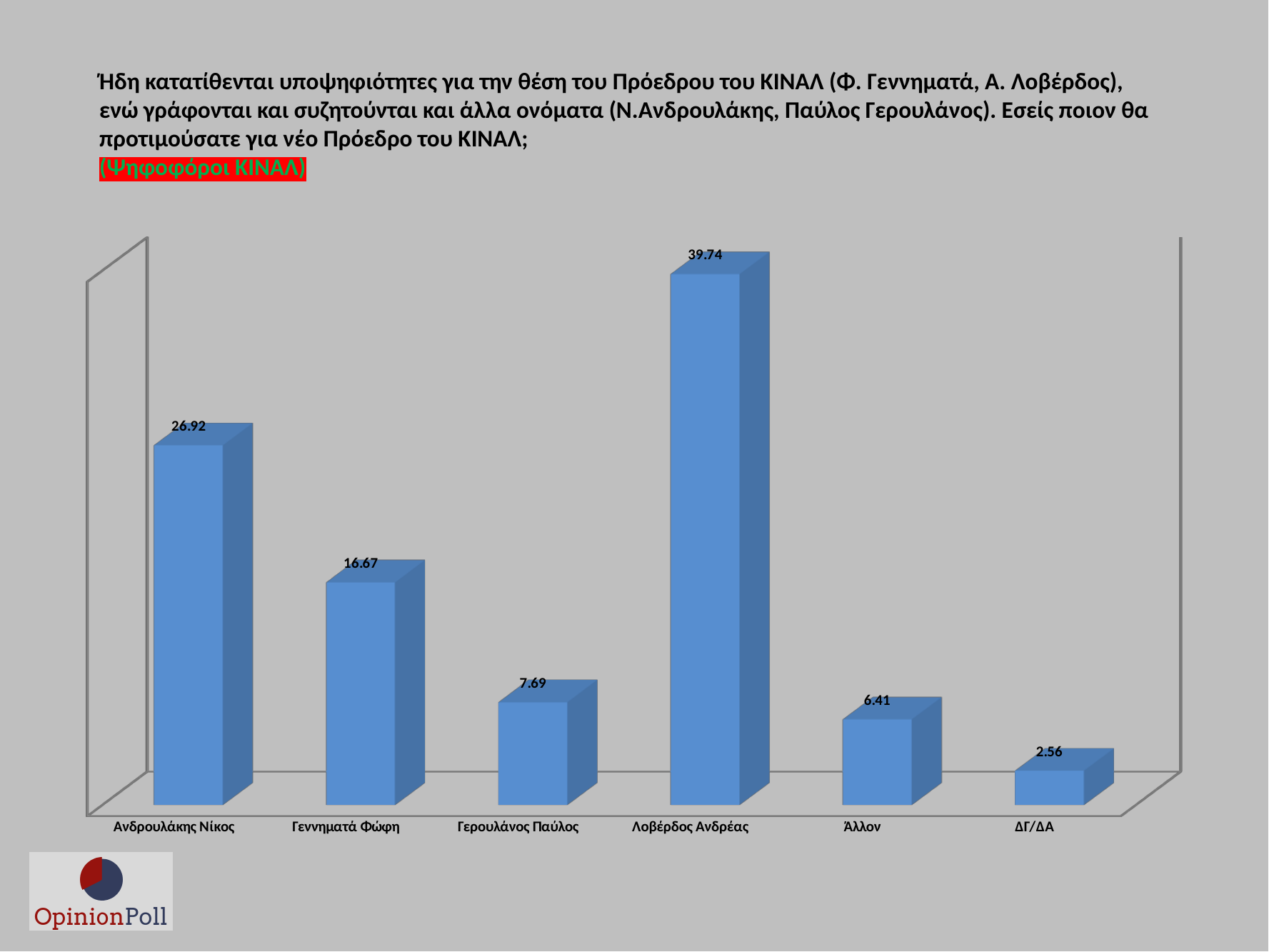
How many categories are shown on the chart? 6 Which category has the highest value? Λοβέρδος Ανδρέας What is the difference between the values for Ανδρουλάκης Νίκος and Γεννηματά Φώφη? 10.25 What is the value shown for ΔΓ/ΔΑ? 2.56 What is the difference between the values for Λοβέρδος Ανδρέας and Ανδρουλάκης Νίκος? 12.82 What is the value shown for Γεννηματά Φώφη? 16.67 What kind of chart is shown on the slide? Bar chart What colour are the bars in the chart? Blue What is the value shown for Ανδρουλάκης Νίκος? 26.92 Which is larger, the value for Γερουλάνος Παύλος or the value for Άλλον? Γερουλάνος Παύλος What is the value shown for Λοβέρδος Ανδρέας? 39.74 Which category has the lowest value? ΔΓ/ΔΑ